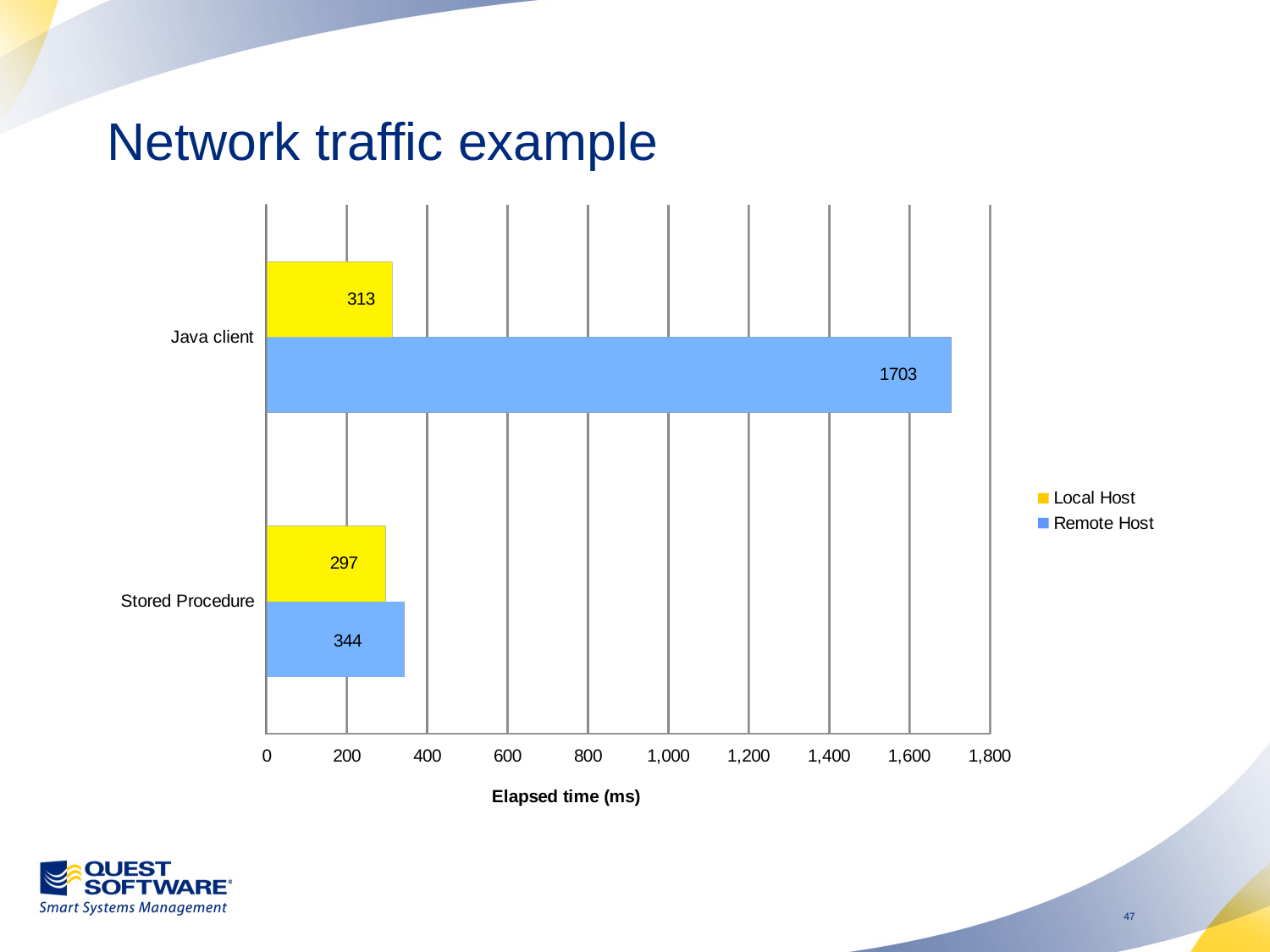
What is the Local Host elapsed time for Java client? 313 Which category has the highest Remote Host value? Java client Which category has the lowest Local Host value? Stored Procedure What is the difference between the Remote Host and Local Host values for Stored Procedure? 47 How many categories are shown on the chart? 2 What is the Remote Host elapsed time for Stored Procedure? 344 What is the Local Host elapsed time for Stored Procedure? 297 What is the difference between the Remote Host and Local Host values for Java client? 1390 What kind of chart is shown on the slide? Bar chart What is the Remote Host elapsed time for Java client? 1703 Which is larger: the Remote Host value for Java client or the Remote Host value for Stored Procedure? Java client How many series does the legend list? 2